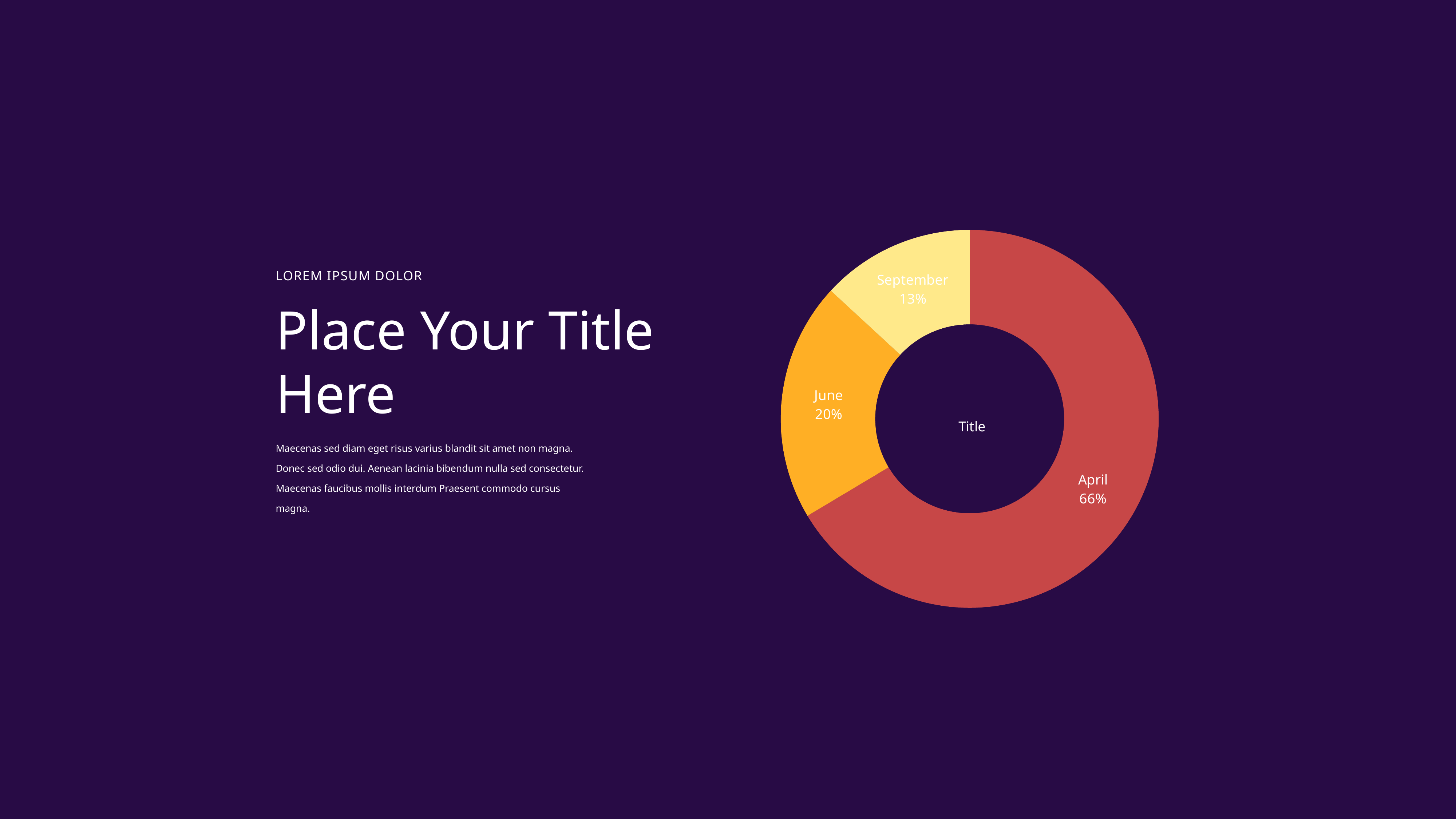
How many slices does the chart have? 3 What is the difference in percentage points between April and June? 46 What is the difference in percentage points between June and September? 7 What text is shown in the centre of the doughnut chart? Title Which is larger, the June slice or the September slice? June Which category has the smallest share of the chart? September What percentage does the June slice represent? 20% What percentage does the April slice represent? 66% What percentage does the September slice represent? 13% What colour is the April slice? Red What kind of chart is shown on the slide? Doughnut chart Which category has the largest share of the chart? April